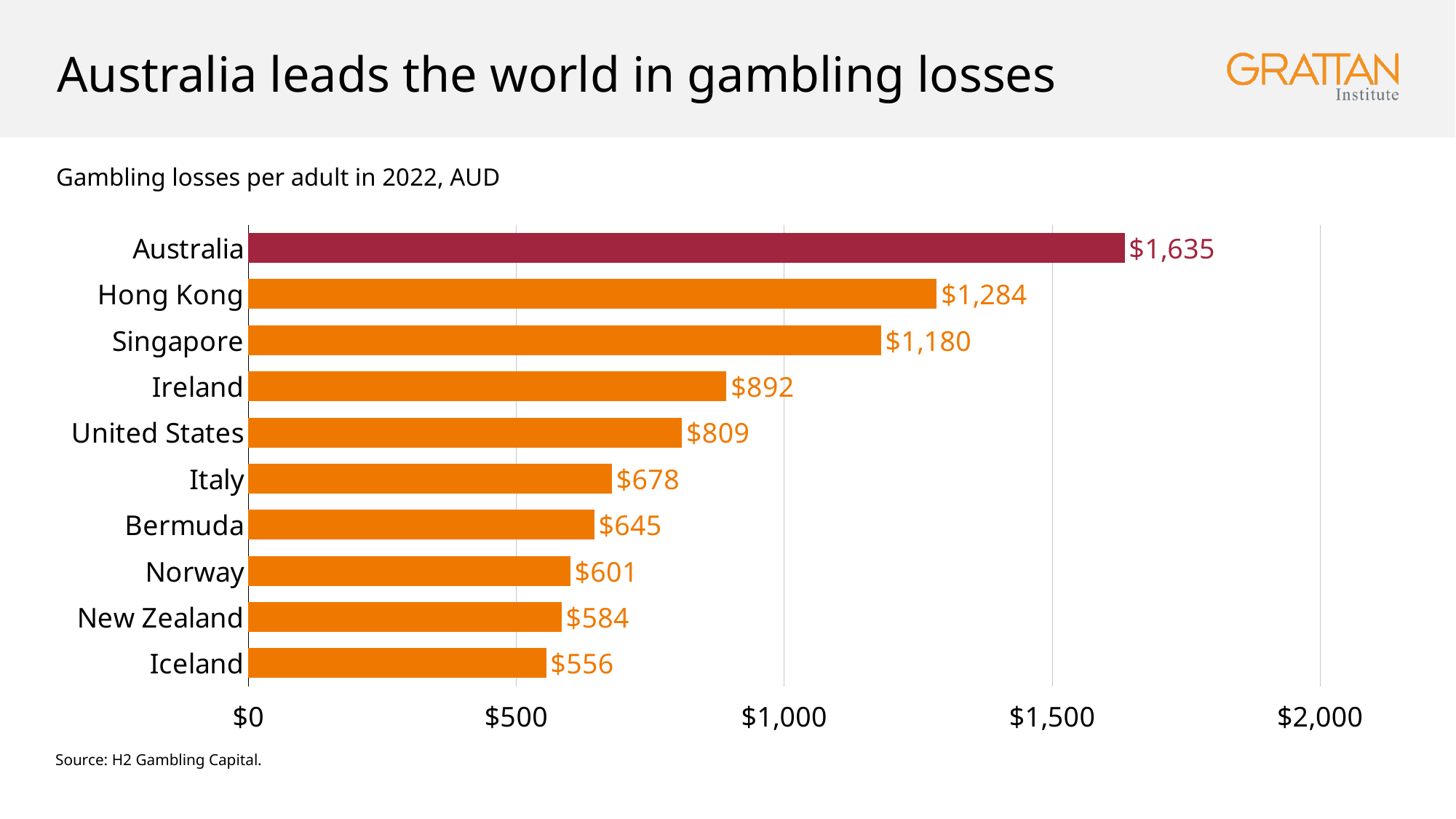
Which has higher gambling losses per adult, Singapore or Ireland? Singapore What are the gambling losses per adult for Norway? $601 What are the gambling losses per adult for Ireland? $892 What is the difference in gambling losses per adult between the United States and Italy? $131 Which country has the highest gambling losses per adult? Australia What is the difference in gambling losses per adult between Australia and Hong Kong? $351 How many countries are shown in the chart? 10 Is the value for Bermuda greater or less than $500? greater What are the gambling losses per adult for Hong Kong? $1,284 Which country's bar is shown in a different colour from the others? Australia What type of chart is shown on the slide? Bar chart Which country has the lowest gambling losses per adult? Iceland